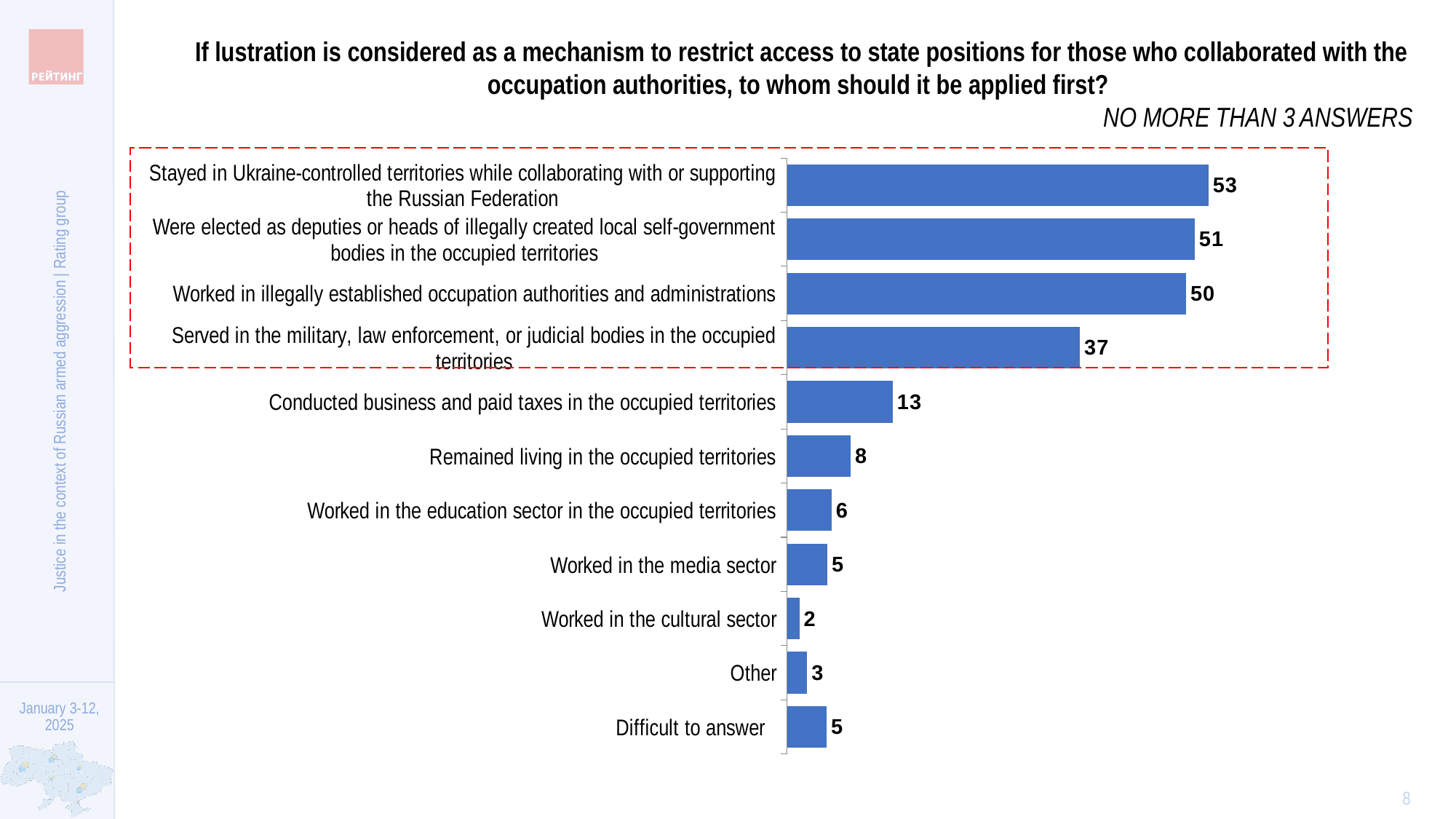
What is the difference between the values for "Were elected as deputies or heads of illegally created local self-government bodies in the occupied territories" and "Worked in illegally established occupation authorities and administrations"? 1 What is the value for "Worked in illegally established occupation authorities and administrations"? 50 What is the value for "Remained living in the occupied territories"? 8 What is the value for "Difficult to answer"? 5 What is the value for "Conducted business and paid taxes in the occupied territories"? 13 How many categories are enclosed in the red dashed box? 4 Which is larger: the value for "Worked in the education sector in the occupied territories" or the value for "Worked in the media sector"? Worked in the education sector in the occupied territories Which category has the lowest value? Worked in the cultural sector What is the difference between the values for "Stayed in Ukraine-controlled territories while collaborating with or supporting the Russian Federation" and "Served in the military, law enforcement, or judicial bodies in the occupied territories"? 16 Which category has the highest value? Stayed in Ukraine-controlled territories while collaborating with or supporting the Russian Federation How many categories are shown in the chart? 11 What kind of chart is shown on the slide? Bar chart